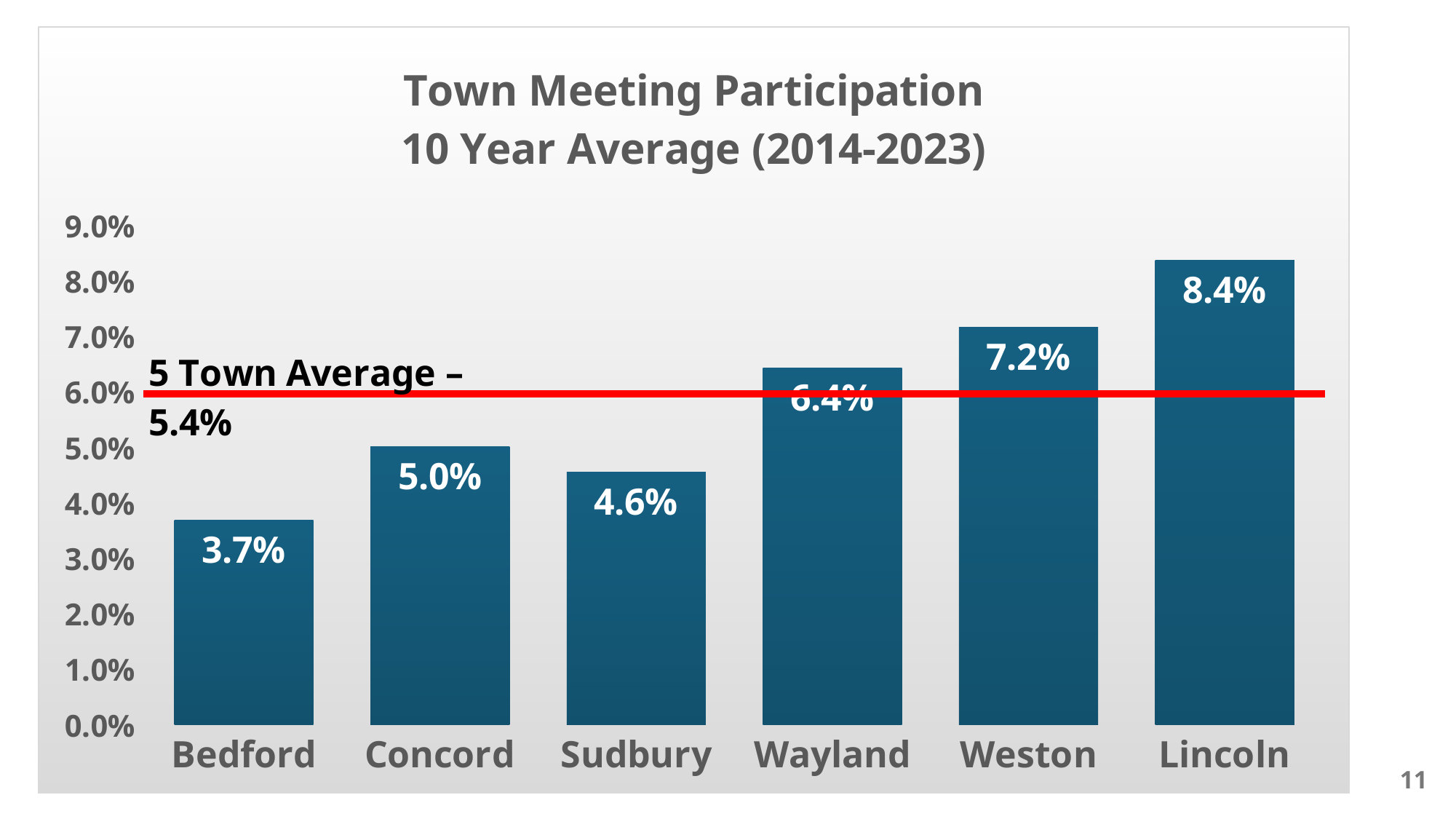
What kind of chart is this? bar chart What is the value for Bedford? 3.7% What is the title of the chart? Town Meeting Participation 10 Year Average (2014-2023) How many towns are shown on the chart? 6 Which town has the highest value? Lincoln Is the value for Weston greater or less than 6.0%? greater What is the value for Sudbury? 4.6% What is the value for Weston? 7.2% What is the difference between the values for Lincoln and Bedford? 4.7% Which is larger, the value for Concord or the value for Wayland? Wayland Which town has the lowest value? Bedford What is the 5 Town Average shown by the red line? 5.4%